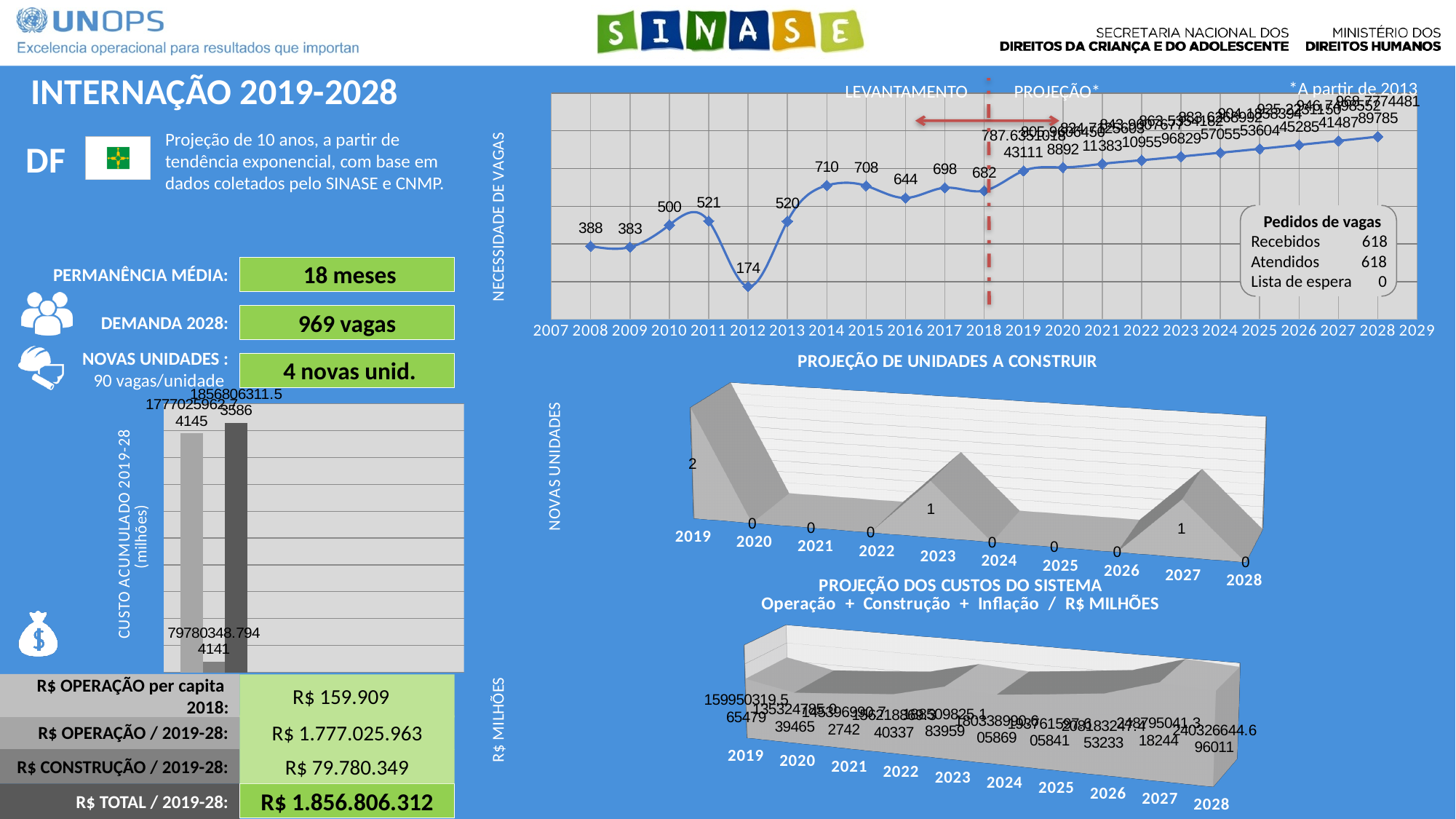
In the PROJEÇÃO DE UNIDADES A CONSTRUIR chart, how many years are shown on the x axis? 10 In the PROJEÇÃO DE UNIDADES A CONSTRUIR chart, what is the value for 2019? 2 In the NECESSIDADE DE VAGAS line chart, what is the value for 2012? 174 In the NECESSIDADE DE VAGAS line chart, which is larger, the value for 2013 or the value for 2016? 2016 In the NECESSIDADE DE VAGAS line chart, do the values rise or fall from 2019 to 2028? rise In the NECESSIDADE DE VAGAS line chart, what is the difference between the values for 2014 and 2012? 536 What kind of chart is the NECESSIDADE DE VAGAS chart at the top right? line chart In the PROJEÇÃO DE UNIDADES A CONSTRUIR chart, what is the total of all the values from 2019 to 2028? 4 In the Pedidos de vagas box on the NECESSIDADE DE VAGAS chart, what is the value for Lista de espera? 0 In the NECESSIDADE DE VAGAS line chart, what is the value for 2014? 710 In the NECESSIDADE DE VAGAS line chart, which year has the highest value? 2028 In the NECESSIDADE DE VAGAS line chart, which year has the lowest value? 2012